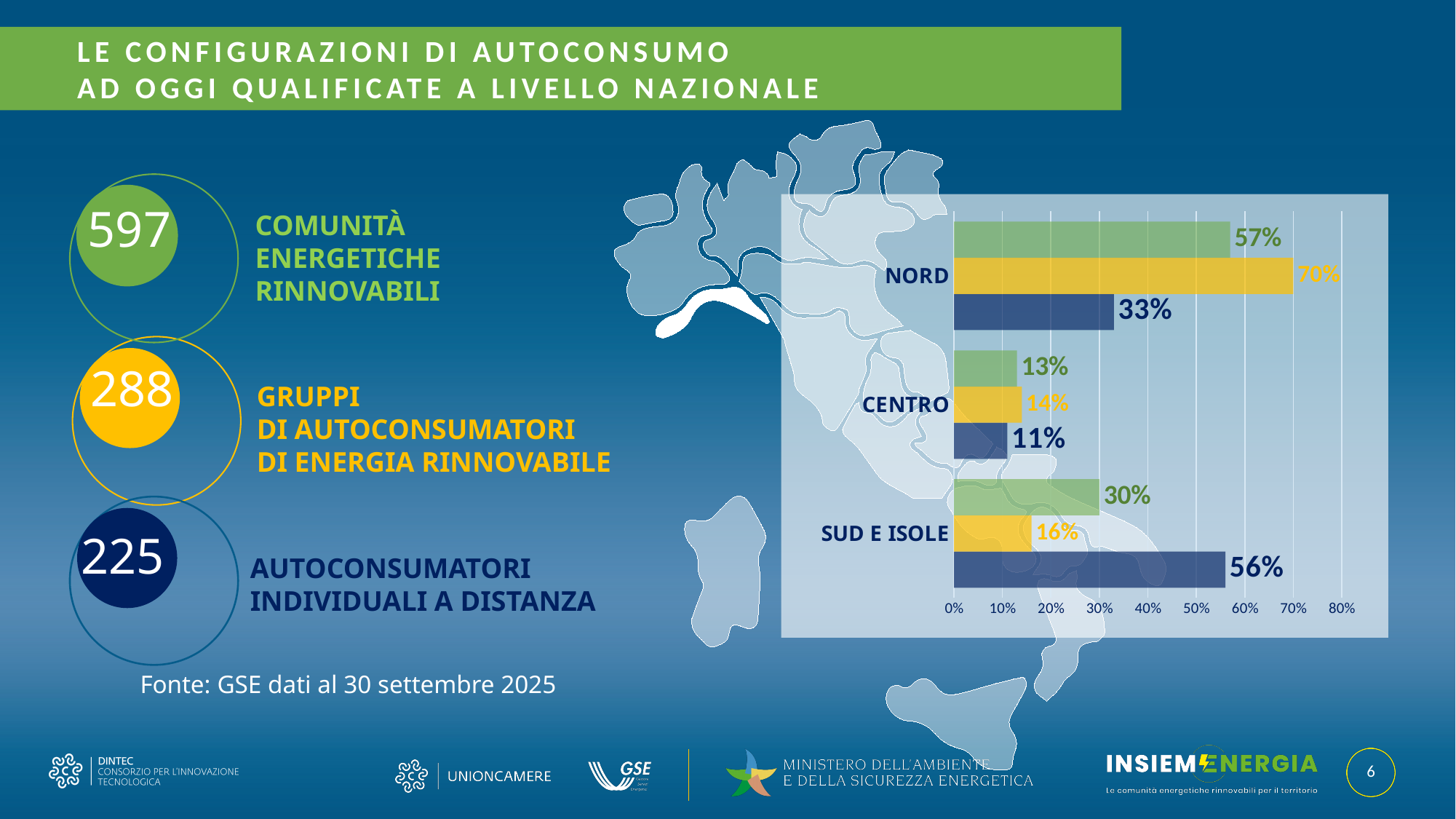
How many regions are shown on the chart's axis? 3 Which region has the lowest value for the dark blue bars? CENTRO What is the value of the green bar for CENTRO? 13% What is the value of the dark blue bar for SUD E ISOLE? 56% What is the difference between the green bar for NORD and the green bar for SUD E ISOLE? 27% Which is larger for SUD E ISOLE, the yellow bar or the dark blue bar? the dark blue bar What is the highest value shown on the chart's horizontal axis? 80% What is the value of the yellow bar for NORD? 70% What is the difference between the yellow bar and the dark blue bar for NORD? 37% Which region has the highest value for the green bars? NORD Is the value of the yellow bar for NORD greater or less than 60%? greater What kind of chart is shown on the slide? bar chart